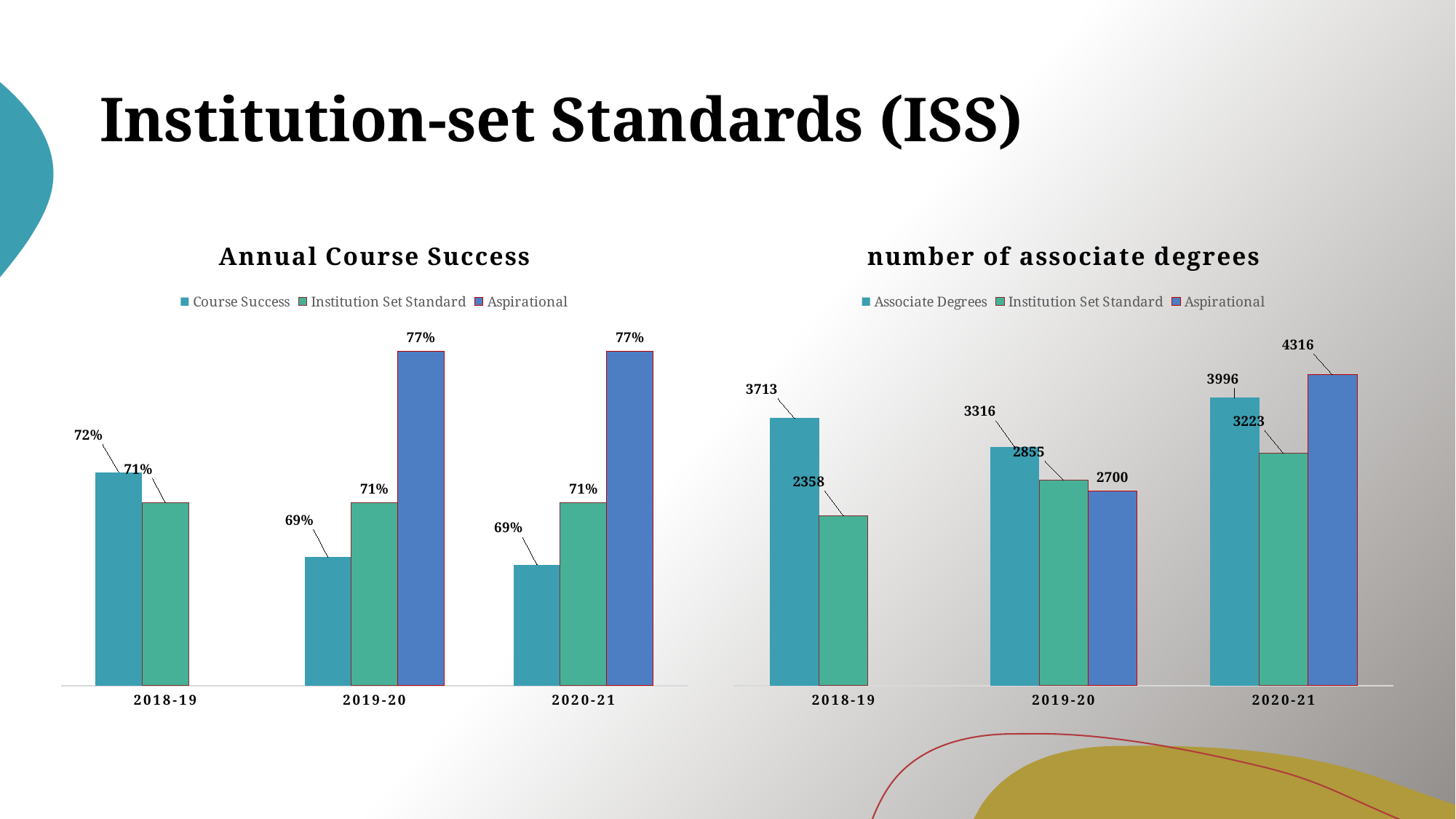
In the 'Annual Course Success' chart, how many series does the legend list? 3 What kind of chart is the 'number of associate degrees' chart? bar chart In the 'Annual Course Success' chart, what is the difference between the Aspirational and Course Success values for 2019-20? 8% In the 'number of associate degrees' chart, what is the Associate Degrees value for 2019-20? 3316 In the 'Annual Course Success' chart, which year has no Aspirational bar? 2018-19 In the 'number of associate degrees' chart, which year has the highest Associate Degrees value? 2020-21 In the 'number of associate degrees' chart, what is the difference between the Aspirational and Associate Degrees values for 2020-21? 320 In the 'Annual Course Success' chart, what is the Aspirational value for 2020-21? 77% In the 'number of associate degrees' chart, is the Associate Degrees value for 2018-19 larger or smaller than the Institution Set Standard value for 2018-19? larger In the 'number of associate degrees' chart, what is the Institution Set Standard value for 2020-21? 3223 In the 'Annual Course Success' chart, what is the Course Success value for 2018-19? 72% In the 'number of associate degrees' chart, which year has the lowest Institution Set Standard value? 2018-19